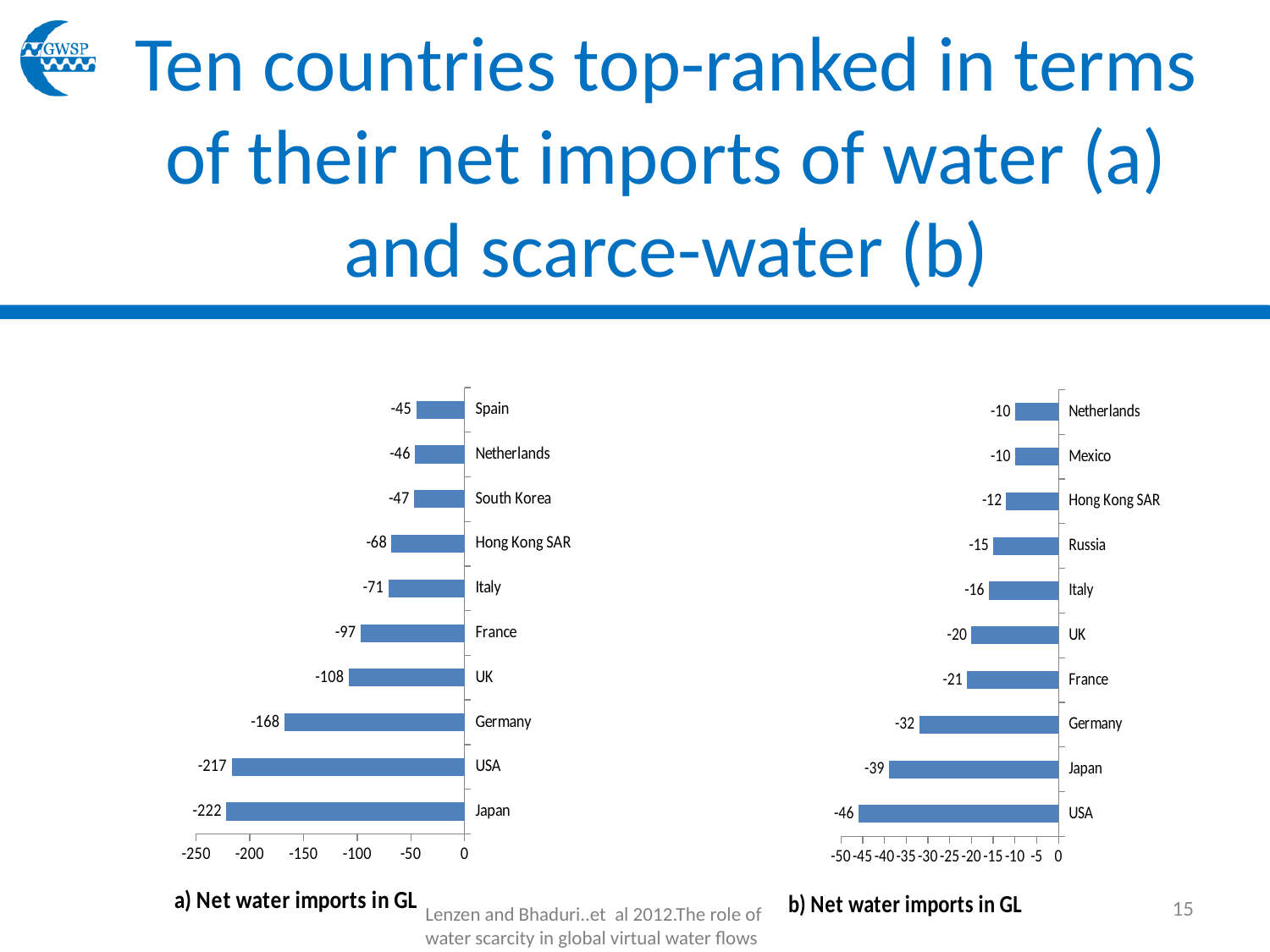
In the right chart (b), which country has the longest bar (most negative value)? USA In the left chart (a), what is the value for Germany? -168 What is the caption below the left chart? a) Net water imports in GL In the left chart (a), which country has the longest bar (most negative value)? Japan In the left chart (a), which bar is longer, France or UK? UK In the right chart (b), what is the value for Japan? -39 What type of chart is the right chart (b)? Bar chart In the right chart (b), what is the value for Russia? -15 In the left chart (a), what is the difference between the values for USA and Germany? 49 In the right chart (b), what is the difference between the values for USA and Germany? 14 How many countries are shown in the left chart (a)? 10 In the left chart (a), what is the value for Hong Kong SAR? -68